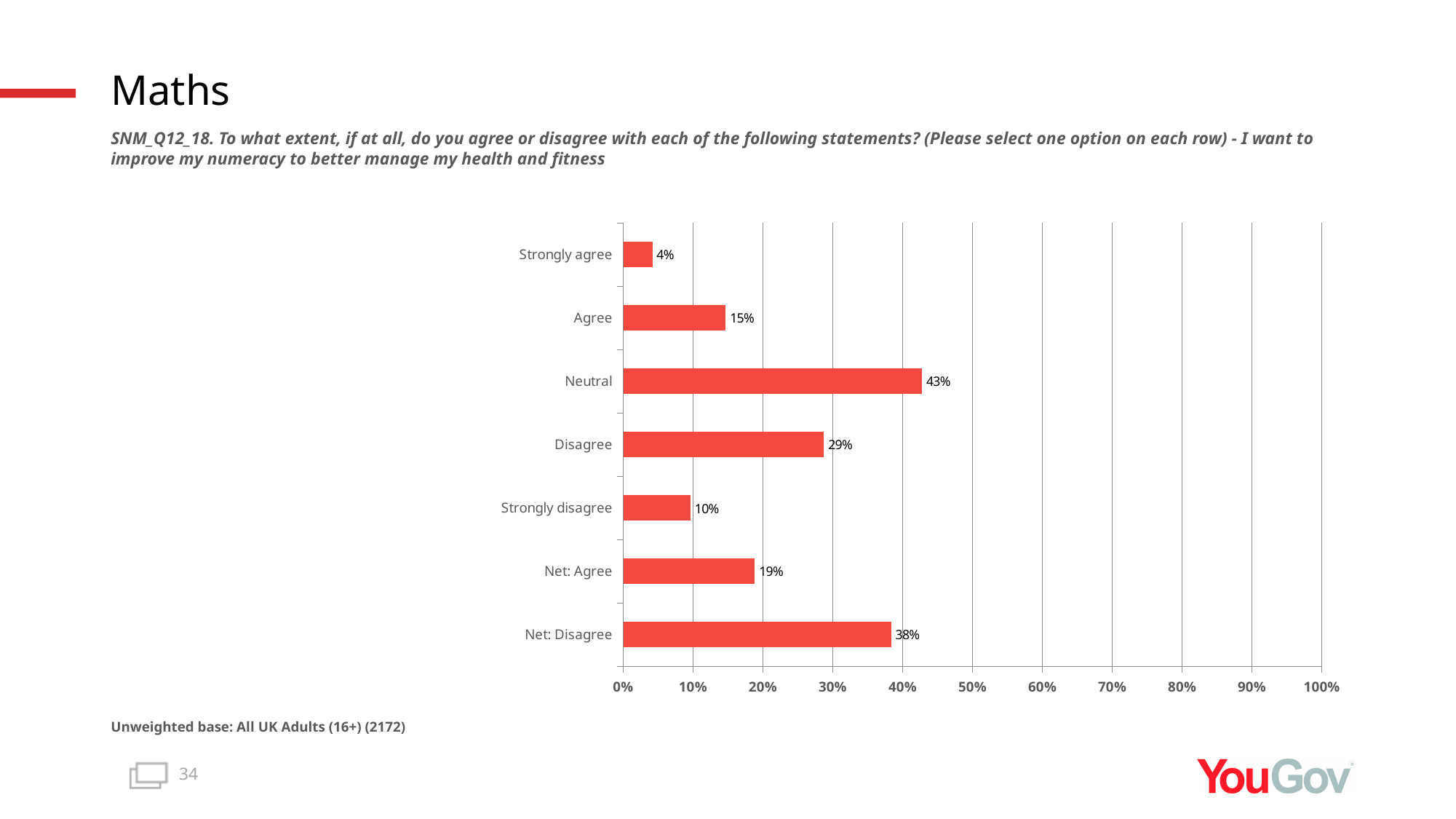
What percentage of respondents answered Neutral? 43% What is the value for Strongly agree? 4% What is the value for Net: Disagree? 38% What is the difference between Disagree and Agree? 14% Is the value for Neutral greater or less than 40%? greater How many categories are shown on the chart? 7 Which category has the highest value? Neutral What kind of chart is shown on the slide? Bar chart What is the unweighted base stated below the chart? All UK Adults (16+) (2172) What is the difference between Net: Disagree and Net: Agree? 19% Which is larger, Disagree or Strongly disagree? Disagree Which category has the lowest value? Strongly agree